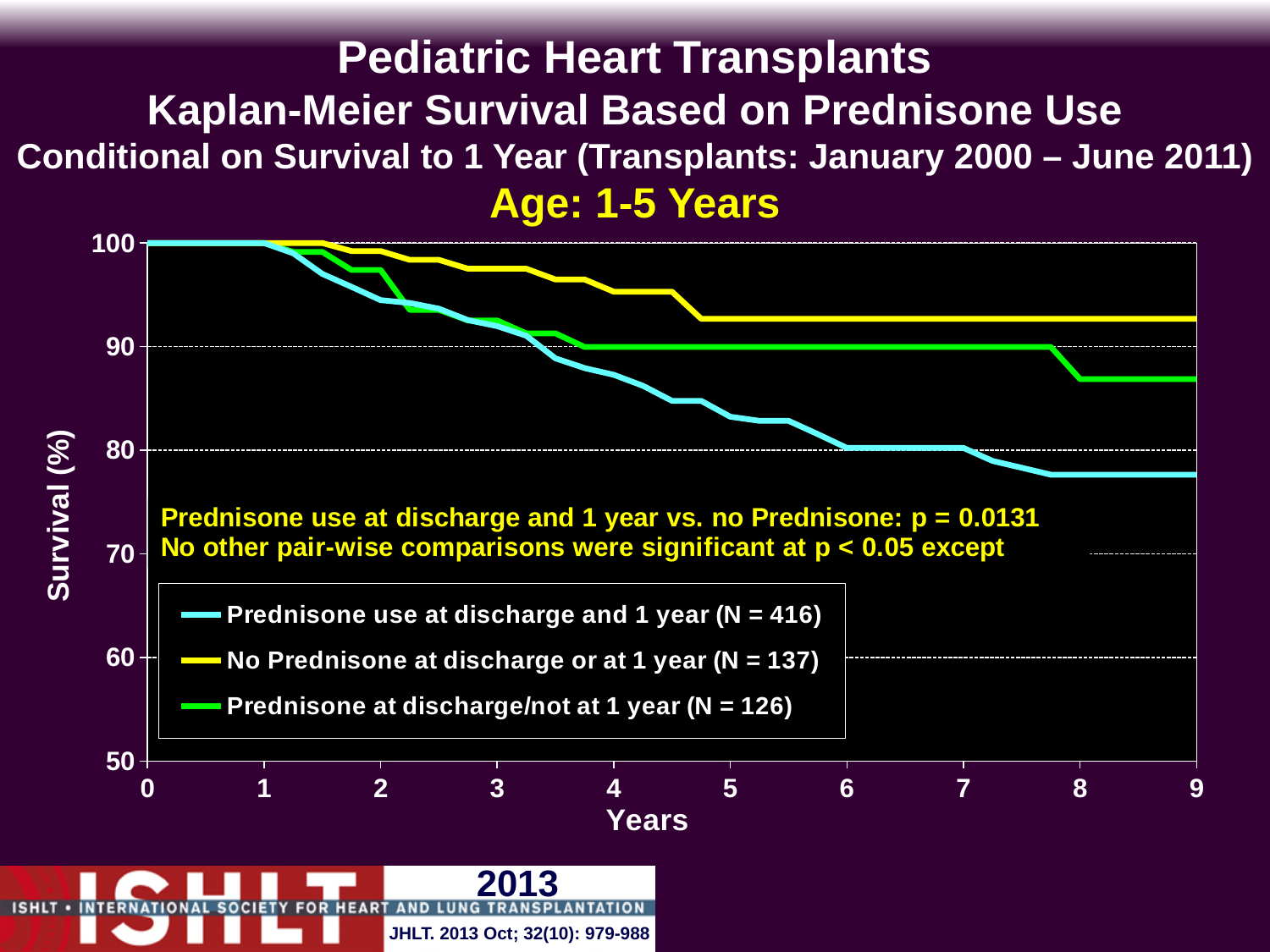
Is the survival for the 'Prednisone use at discharge and 1 year' group at 5 years greater or less than 80? greater Which series has the highest survival at 9 years? No Prednisone at discharge or at 1 year (N = 137) What is the N for the 'Prednisone use at discharge and 1 year' group in the legend? 416 Which series has the lowest survival at 9 years? Prednisone use at discharge and 1 year (N = 416) Is the survival for the 'No Prednisone at discharge or at 1 year' group at 9 years greater or less than 90? greater Is the survival for the 'Prednisone at discharge/not at 1 year' group at 9 years greater or less than 90? less At 9 years, is survival higher for the 'No Prednisone at discharge or at 1 year' group or the 'Prednisone use at discharge and 1 year' group? No Prednisone at discharge or at 1 year What age group does the chart cover? 1-5 Years What kind of chart is shown on the slide? line chart How many series does the legend list? 3 Do the survival curves rise or fall as years increase? fall